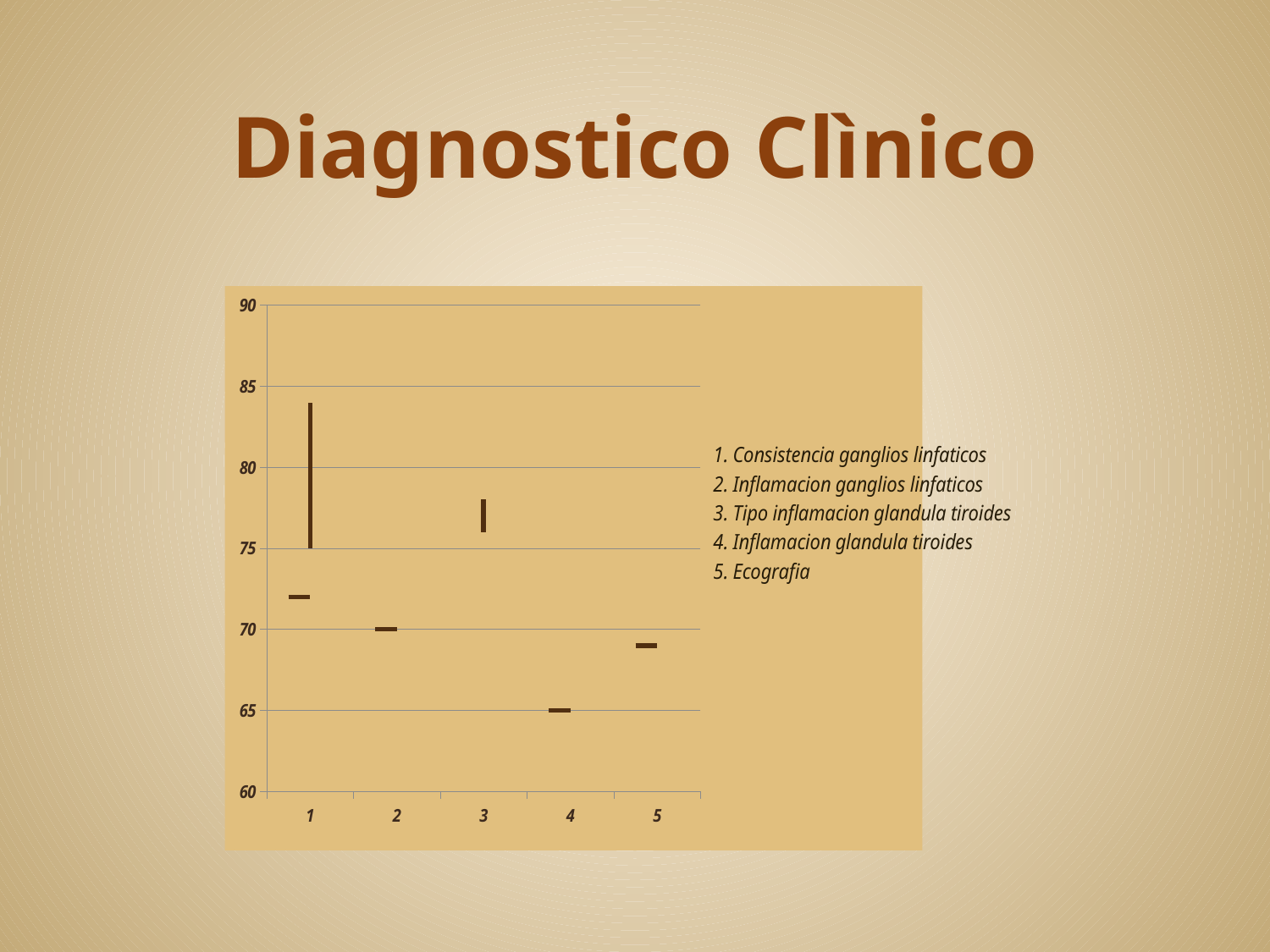
Is the top of the bar for category 1 greater or less than 80? greater How many categories are plotted along the x axis of the chart? 5 Is the bar for category 3 greater or less than 75? greater Which is larger, the value for category 2 or the value for category 4? category 2 What is the title of the slide containing the chart? Diagnostico Clìnico According to the key next to the chart, what does category 5 represent? Ecografia Which category has the lowest value on the chart? 4 Is the value for category 4 greater or less than 70? less What value does the marker for category 2 sit on? 70 What value does the marker for category 4 sit on? 65 Which category reaches the highest value on the chart? 1